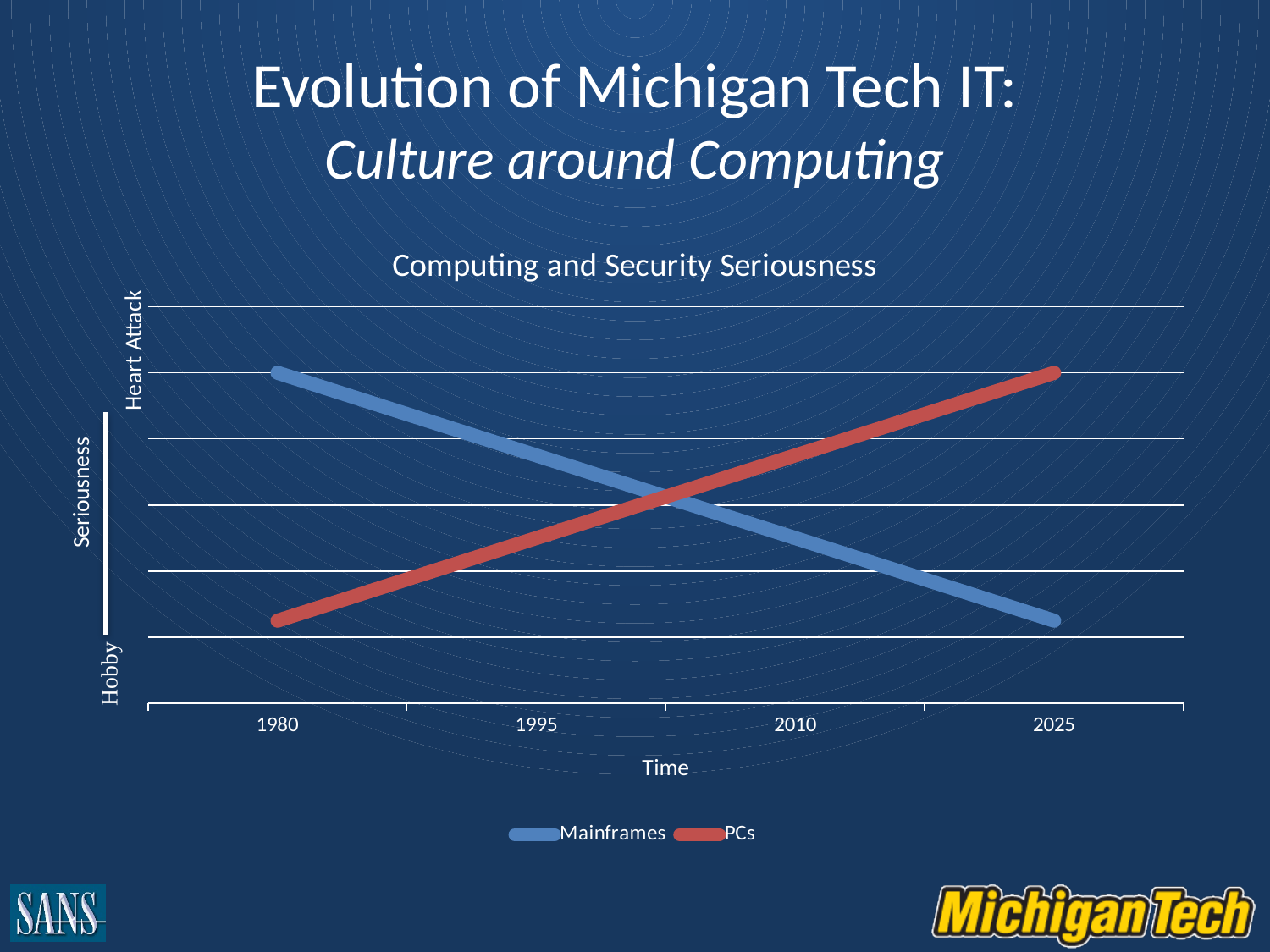
Does the PCs line rise or fall from 1980 to 2025? Rise What is the first year labelled on the x axis of the chart? 1980 In 1980, which series has the higher seriousness value, Mainframes or PCs? Mainframes How many years are labelled along the x axis of the chart? 4 What kind of chart is shown on the slide? Line chart What is the title of the chart? Computing and Security Seriousness How many series does the legend of the chart list? 2 Does the Mainframes line rise or fall from 1980 to 2025? Fall What are the two series named in the chart legend? Mainframes and PCs In 2025, which series has the higher seriousness value, Mainframes or PCs? PCs What is the last year labelled on the x axis of the chart? 2025